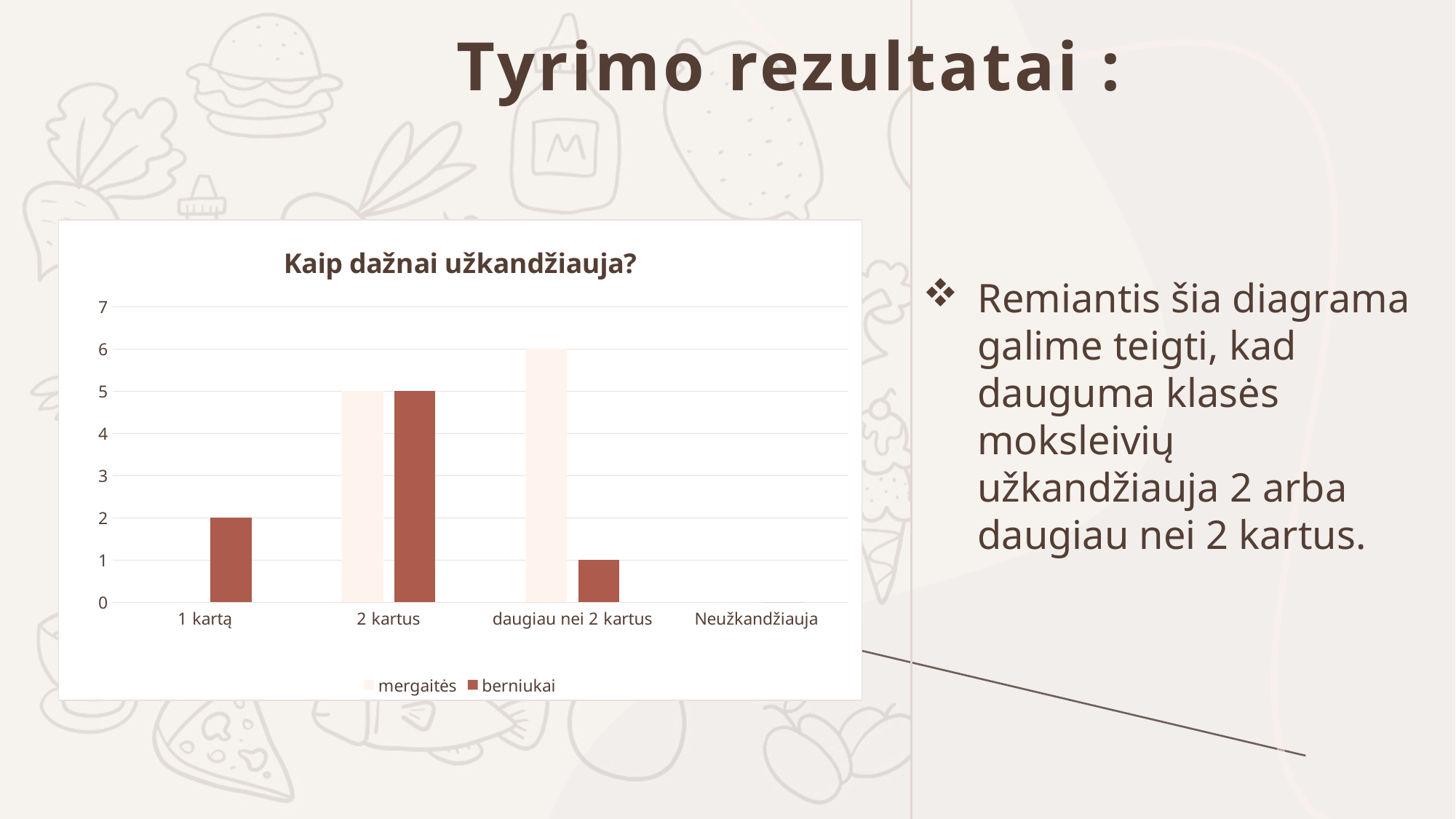
In the 'daugiau nei 2 kartus' category, what is the difference between the mergaitės value and the berniukai value? 5 How many categories are shown on the x axis of the chart? 4 How many series does the chart's legend list? 2 What is the title of the chart? Kaip dažnai užkandžiauja? What is the value for berniukai in the '1 kartą' category? 2 Which category has the highest value for berniukai? 2 kartus In the 'daugiau nei 2 kartus' category, which series has the larger value, mergaitės or berniukai? mergaitės What is the value for mergaitės in the '2 kartus' category? 5 What kind of chart is shown on the slide? bar chart What is the value for berniukai in the 'daugiau nei 2 kartus' category? 1 What is the value for mergaitės in the 'daugiau nei 2 kartus' category? 6 Which category has the highest value for mergaitės? daugiau nei 2 kartus